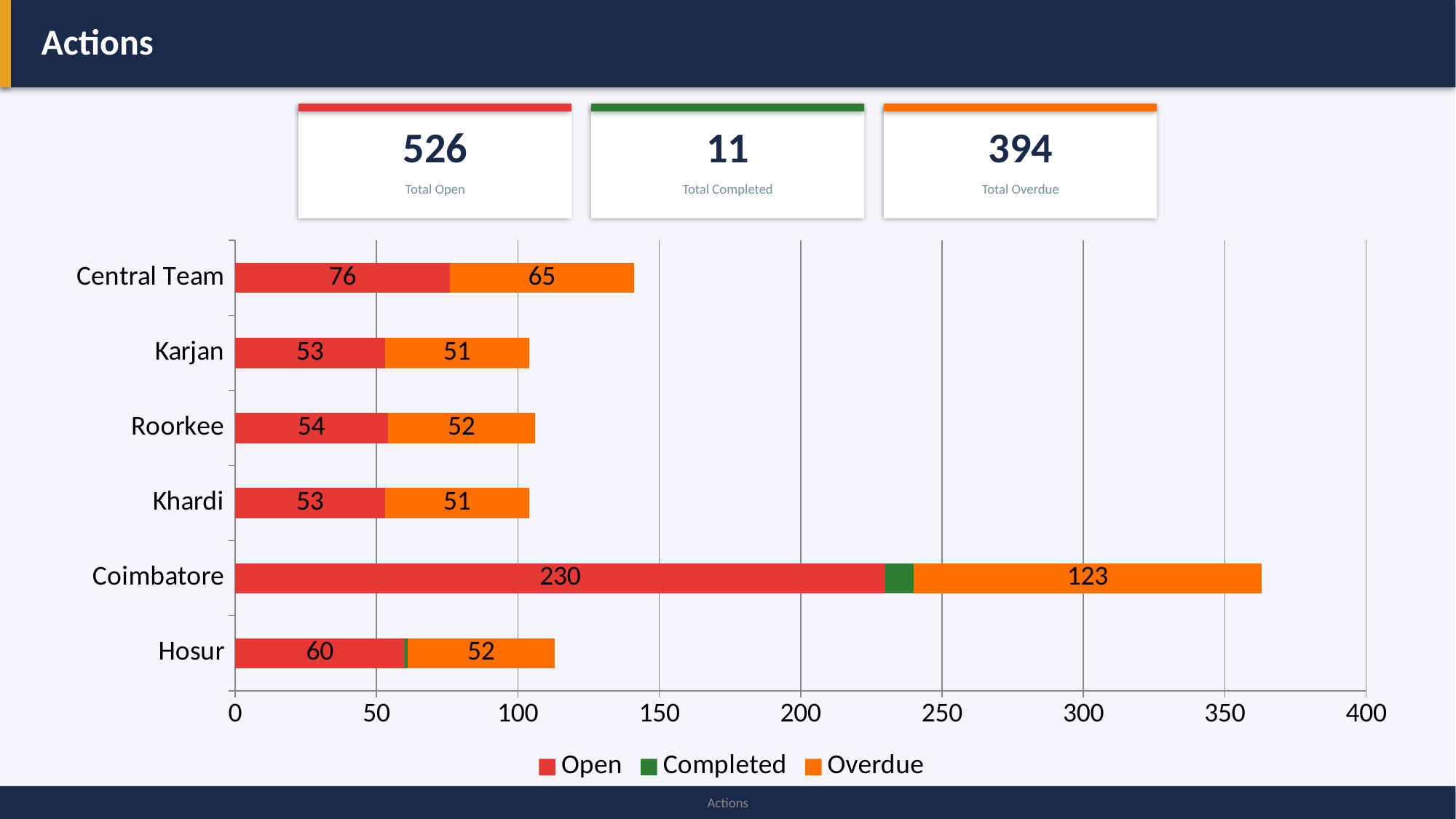
Which category has the lowest Overdue value? Karjan and Khardi How many series does the legend list? 3 What is the Overdue value for Central Team? 65 How many categories are shown on the y axis? 6 Is the total length of the Coimbatore bar greater or less than 350? greater What is the Open value for Hosur? 60 What is the difference between the Open values for Coimbatore and Central Team? 154 What is the total of the Central Team bar (Open plus Overdue)? 141 What kind of chart is shown on the slide? Stacked bar chart Which is larger, the Open value for Roorkee or the Open value for Karjan? Roorkee What is the Open value for Coimbatore? 230 Which category has the highest Overdue value? Coimbatore